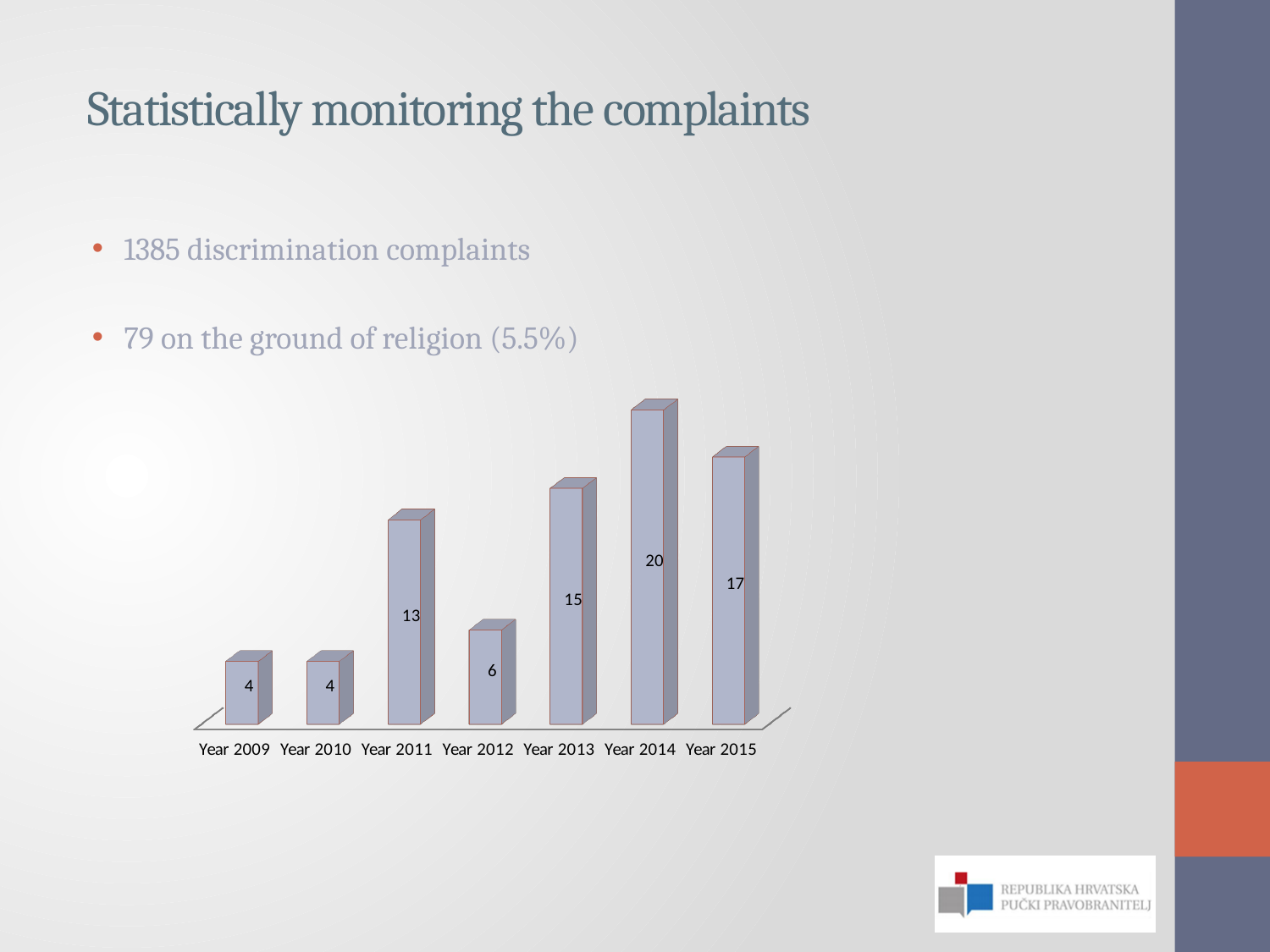
How many years are shown on the chart? 7 What is the value for Year 2011? 13 Which is larger, the value for Year 2011 or the value for Year 2013? Year 2013 What is the value for Year 2012? 6 Which two years share the same lowest value? Year 2009 and Year 2010 What is the difference between the values for Year 2014 and Year 2015? 3 What is the difference between the values for Year 2013 and Year 2012? 9 Do the values rise or fall from Year 2009 to Year 2014? rise Which year has the highest value? Year 2014 What is the value for Year 2015? 17 What is the value for Year 2014? 20 What kind of chart is shown on the slide? bar chart